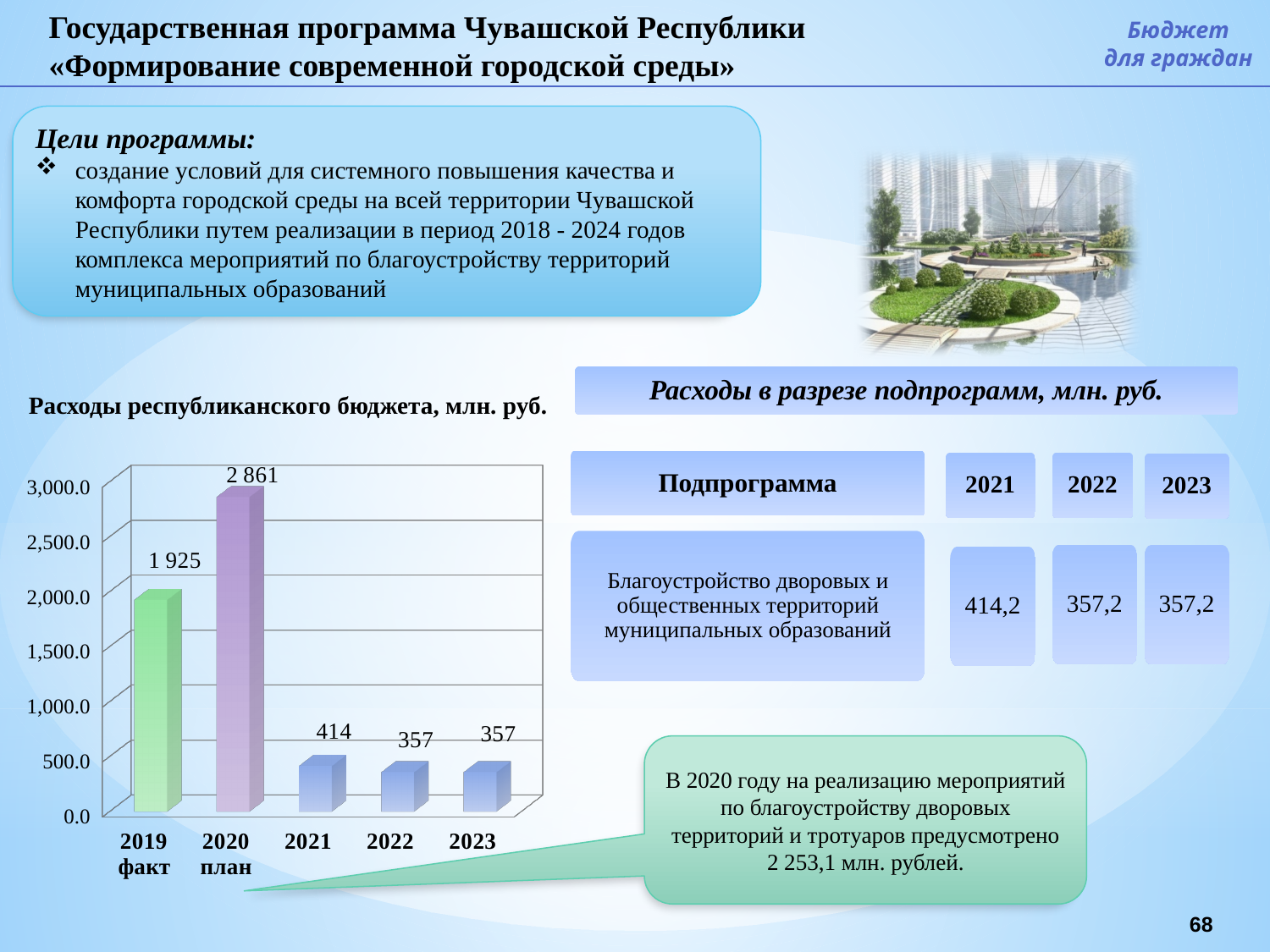
Which is larger in the chart «Расходы республиканского бюджета, млн. руб.»: the value for 2019 факт or the value for 2021? 2019 факт How many categories are shown on the x axis of the chart «Расходы республиканского бюджета, млн. руб.»? 5 What is the value for 2019 факт in the chart «Расходы республиканского бюджета, млн. руб.»? 1 925 What is the value for 2021 in the chart «Расходы республиканского бюджета, млн. руб.»? 414 What kind of chart is «Расходы республиканского бюджета, млн. руб.»? bar chart Do the values in the chart «Расходы республиканского бюджета, млн. руб.» rise or fall from 2020 план to 2023? fall What is the difference between the values for 2020 план and 2019 факт in the chart «Расходы республиканского бюджета, млн. руб.»? 936 What is the value for 2023 in the chart «Расходы республиканского бюджета, млн. руб.»? 357 What is the difference between the values for 2021 and 2022 in the chart «Расходы республиканского бюджета, млн. руб.»? 57 Which category has the highest value in the chart «Расходы республиканского бюджета, млн. руб.»? 2020 план What is the value for 2020 план in the chart «Расходы республиканского бюджета, млн. руб.»? 2 861 Is the value for 2020 план greater or less than 2,500.0 in the chart «Расходы республиканского бюджета, млн. руб.»? greater